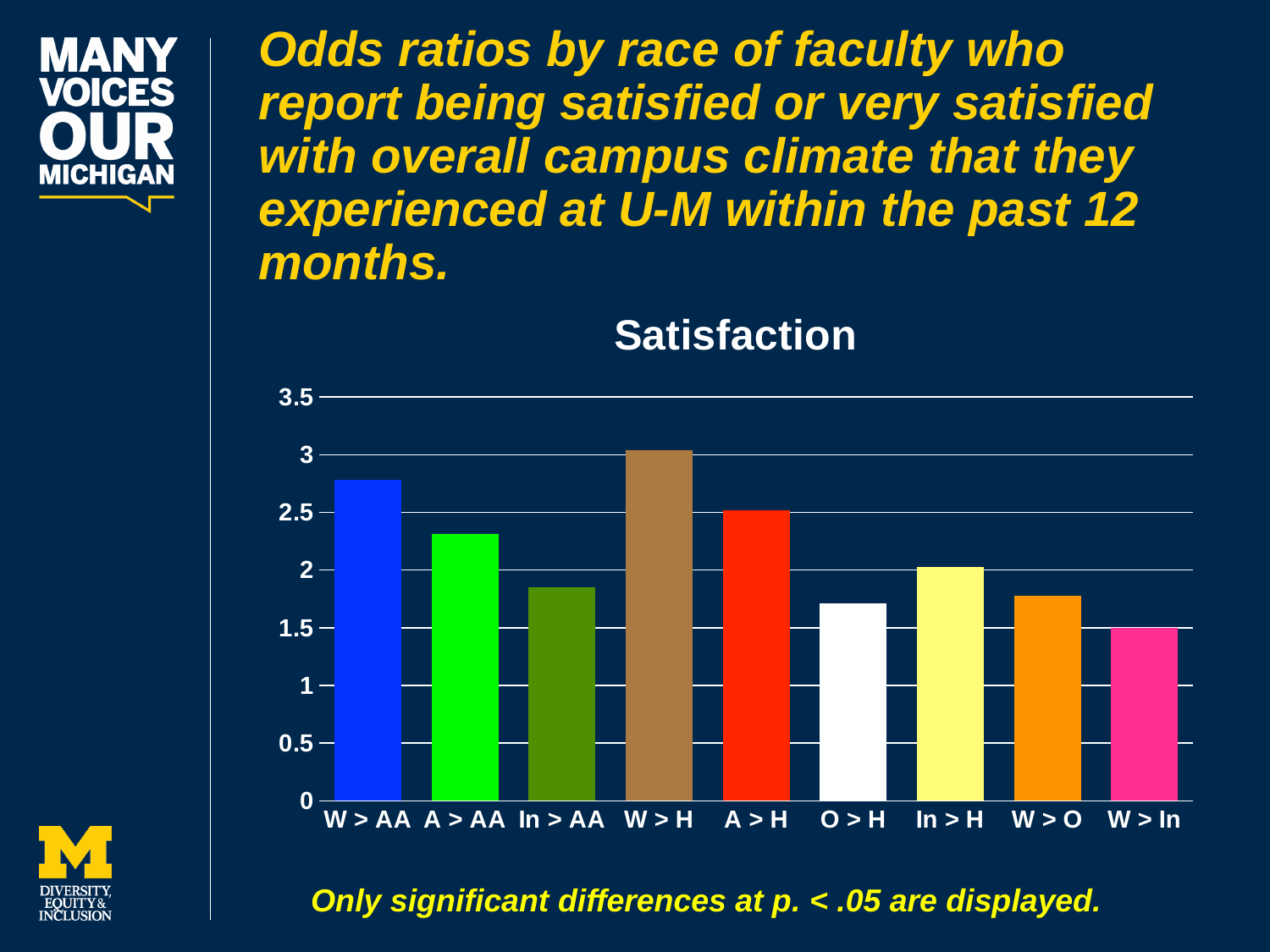
Is the value for O > H greater or less than 2? less Which is larger, the value for In > H or the value for W > In? In > H Which category has the lowest odds ratio? W > In What type of chart is shown on the slide? bar chart Which is larger, the value for W > AA or the value for A > AA? W > AA Is the value for A > H greater or less than 2? greater What is the title of the chart? Satisfaction Is the value for W > AA greater or less than 2.5? greater Which category has the highest odds ratio? W > H How many categories (bars) are shown in the chart? 9